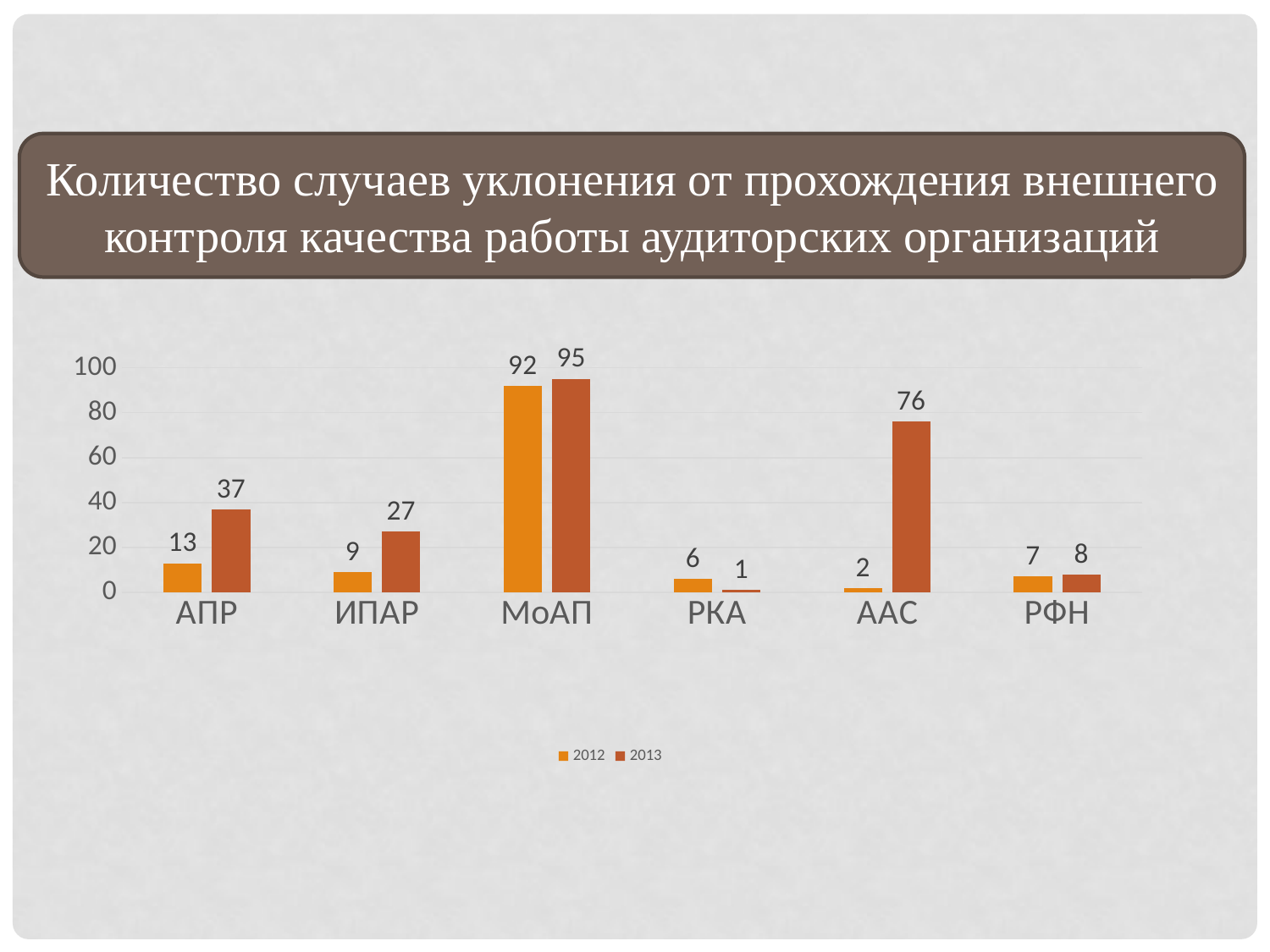
Which category has the highest value in 2013? МоАП What is the value for ИПАР in 2013? 27 Which is larger for РКА: the 2012 value or the 2013 value? 2012 What is the value for ААС in 2012? 2 What kind of chart is shown on the slide? bar chart How many categories are shown on the x axis? 6 What is the value for МоАП in 2013? 95 How many series does the legend list? 2 Which category has the lowest value in 2013? РКА What is the difference between the 2013 and 2012 values for ААС? 74 Which series does the darker red-brown colour represent in the legend? 2013 What is the difference between the 2013 values for АПР and ИПАР? 10